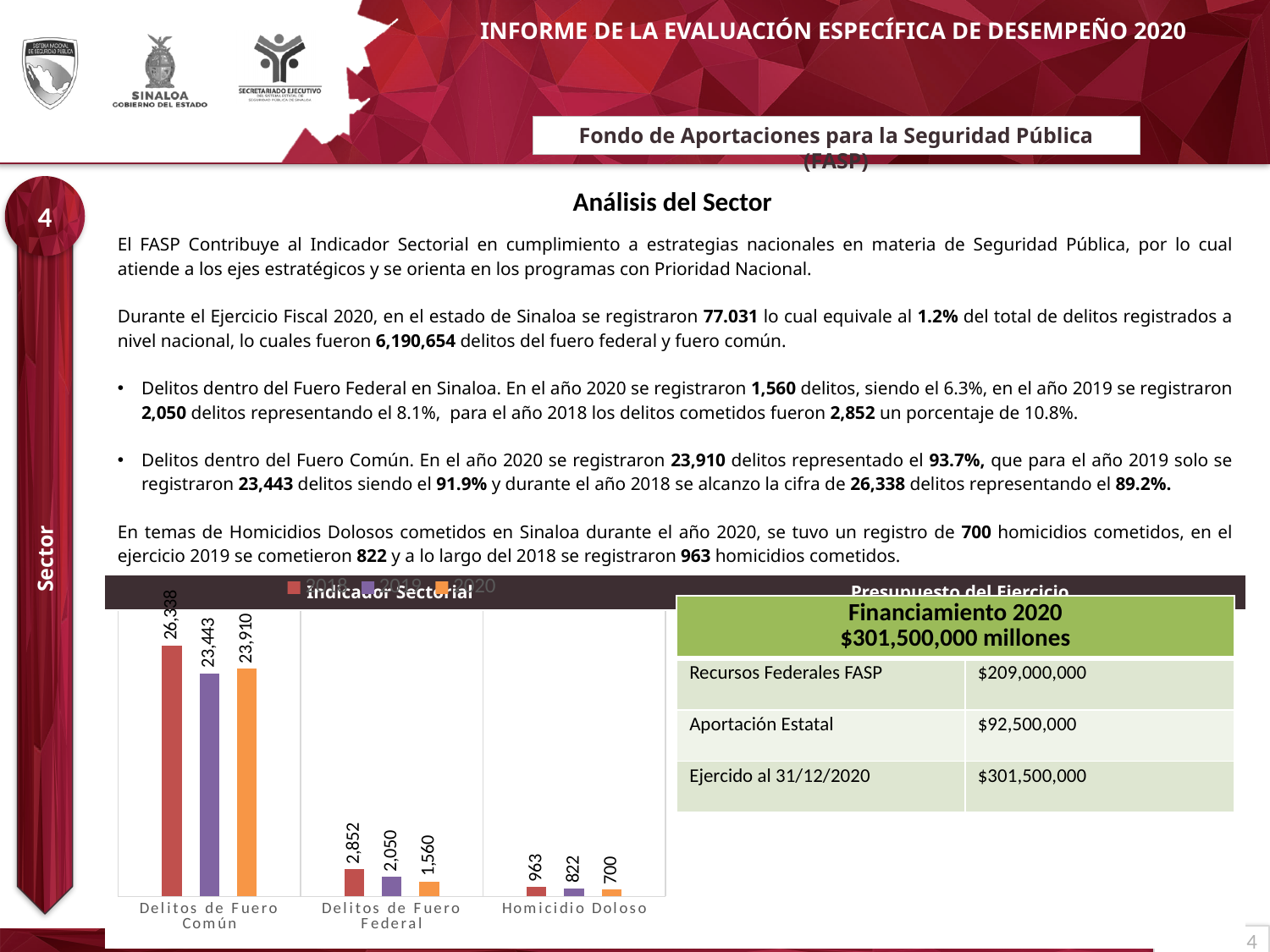
Which is larger for Delitos de Fuero Común: the 2019 value or the 2020 value? 2020 What is the value for Delitos de Fuero Común in 2018? 26,338 How many series does the chart's legend list? 3 What is the title of the chart? Indicador Sectorial How many categories are shown on the x axis of the chart? 3 What is the value for Delitos de Fuero Federal in 2020? 1,560 Which category has the lowest value in 2020? Homicidio Doloso Do the values for Homicidio Doloso rise or fall from 2018 to 2020? fall What is the value for Homicidio Doloso in 2019? 822 Which category has the highest value in 2018? Delitos de Fuero Común What is the difference between the 2018 and 2020 values for Delitos de Fuero Federal? 1,292 What kind of chart is shown on the slide? bar chart